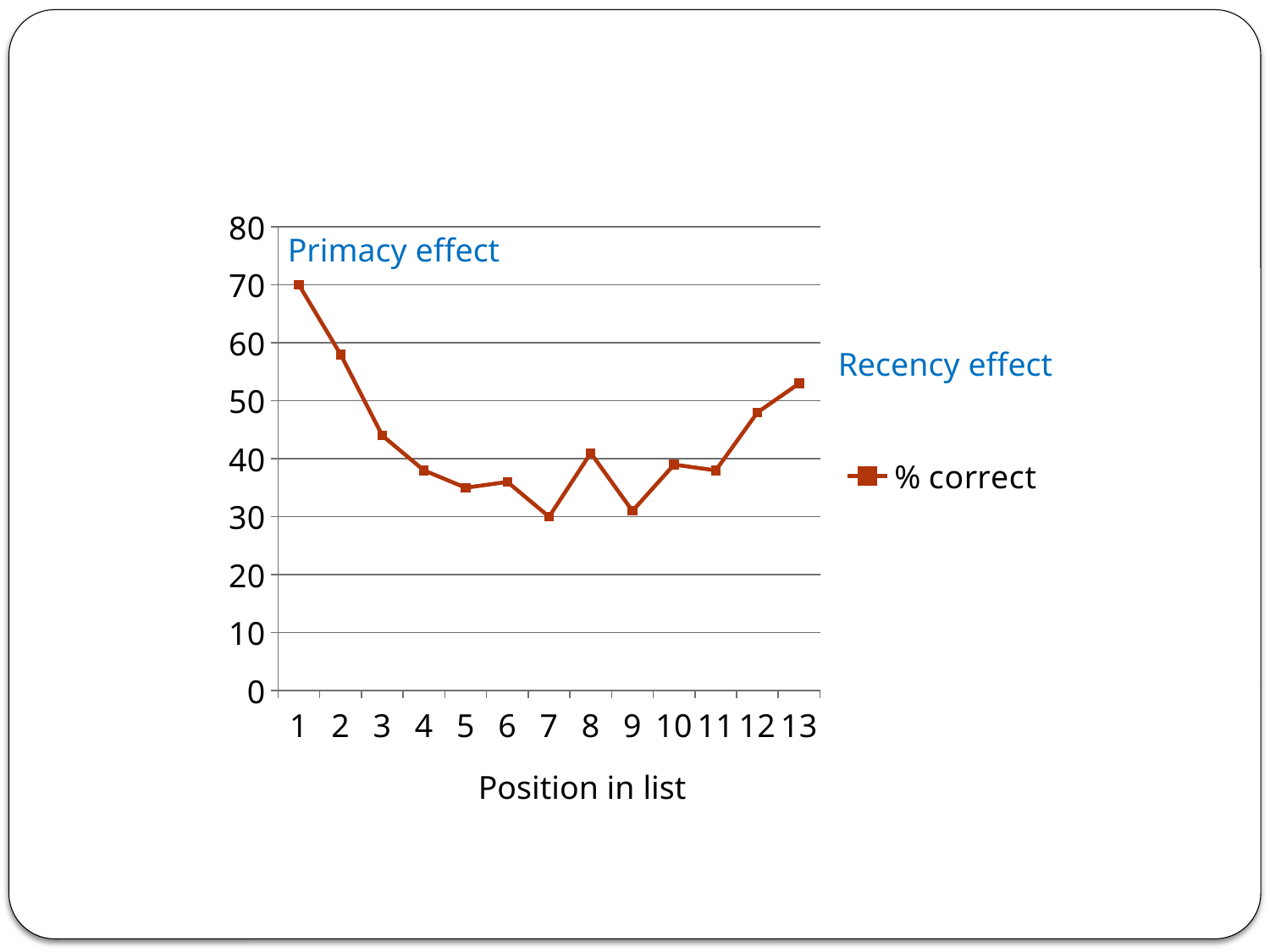
How many positions in the list are plotted on the x axis? 13 Which position in the list has the lowest % correct? 7 What kind of chart is shown on the slide? line chart What is the label of the x axis? Position in list What is the % correct for position 1? 70 What is the name of the series shown in the legend? % correct Is the % correct for position 5 greater or less than 40? less Is the % correct for position 13 greater or less than 50? greater Which position in the list has the highest % correct? 1 What is the % correct for position 7? 30 How many series does the legend list? 1 Which has a higher % correct, position 2 or position 12? position 2